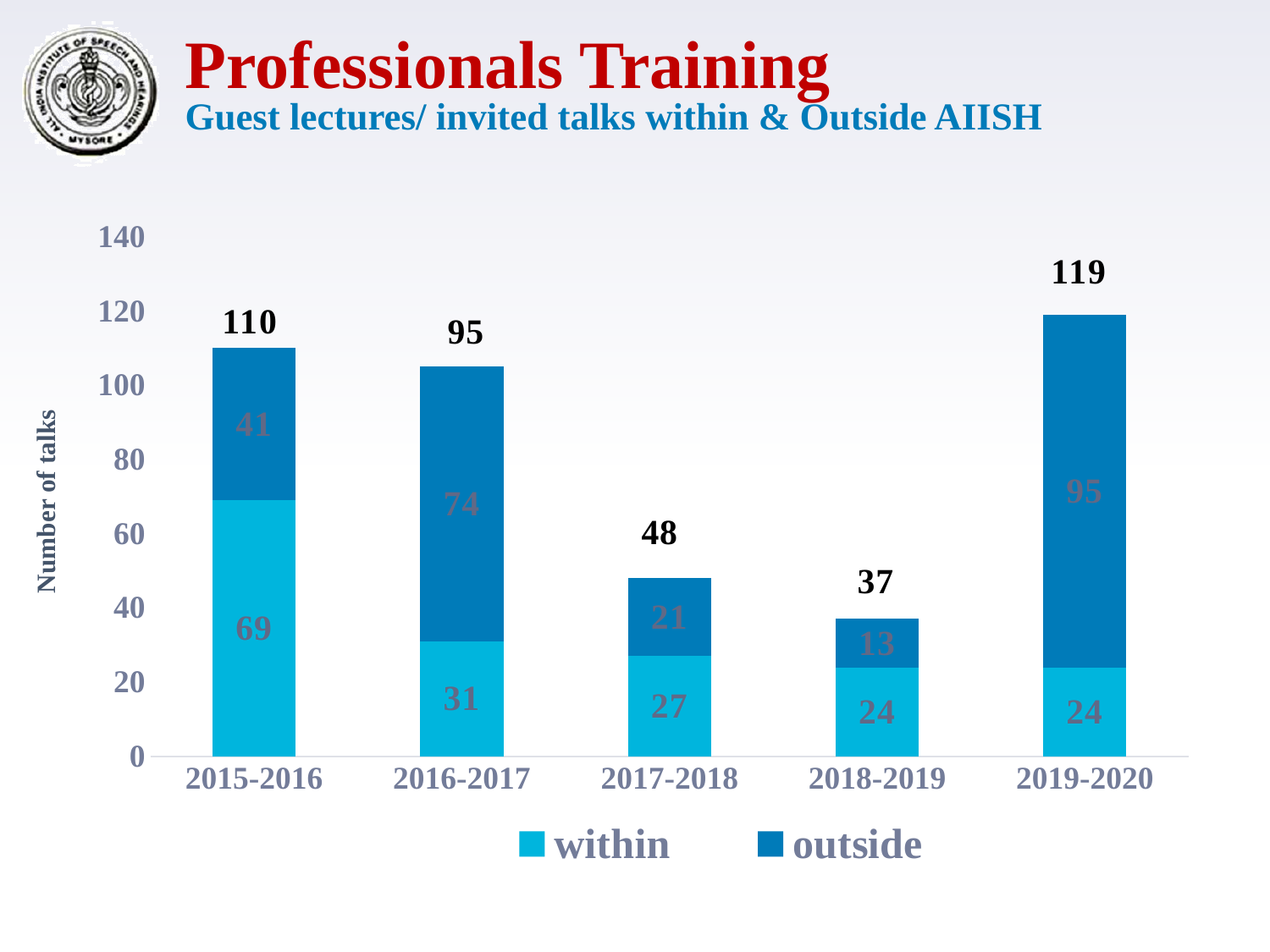
What kind of chart is shown on the slide? Stacked bar chart How many series does the legend list? 2 How many guest lectures/invited talks were given within AIISH in 2015-2016? 69 Which year has the highest total number of talks? 2019-2020 What is the total number of talks shown for 2019-2020? 119 How many talks were given outside AIISH in 2019-2020? 95 Is the total number of talks for 2017-2018 greater or less than 60? less Which year has the lowest total number of talks? 2018-2019 What is the label on the vertical axis of the chart? Number of talks How many academic years are shown on the x axis? 5 What is the difference between the number of outside talks in 2019-2020 and in 2018-2019? 82 Which is larger: the number of within talks in 2015-2016 or in 2016-2017? 2015-2016